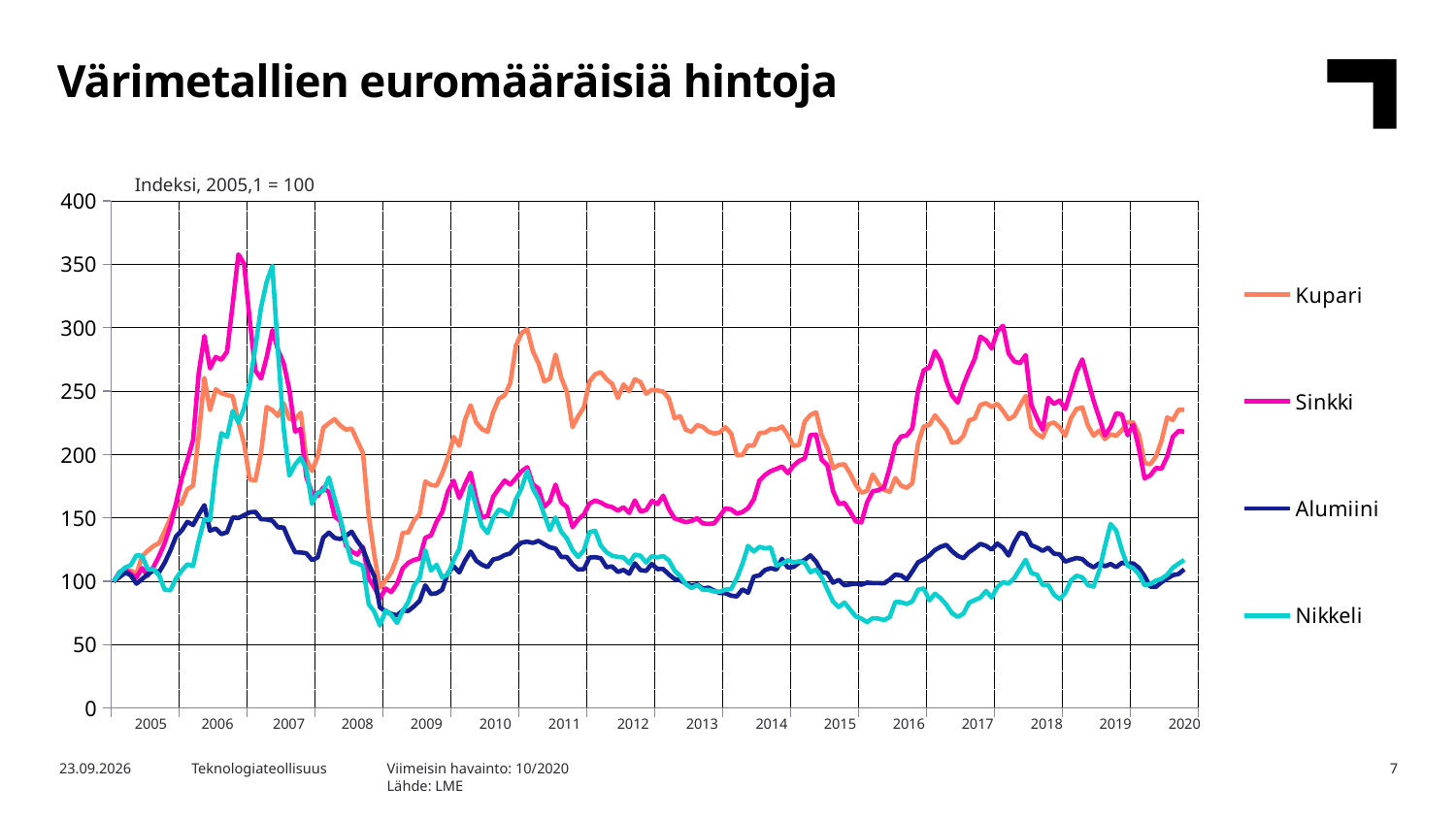
Is the peak value of Nikkeli around 2007 greater or less than 300? greater Which series are listed in the legend? Kupari, Sinkki, Alumiini, Nikkeli Which series reaches the highest value during 2017? Sinkki Which series has the lowest values during 2016? Nikkeli How many year labels are shown on the x axis? 16 Is the lowest value of Nikkeli in 2008 greater or less than 100? less Is the peak value of Sinkki in 2006 greater or less than 300? greater What is the title of the slide? Värimetallien euromääräisiä hintoja How many series does the legend list? 4 What kind of chart is shown on the slide? line chart